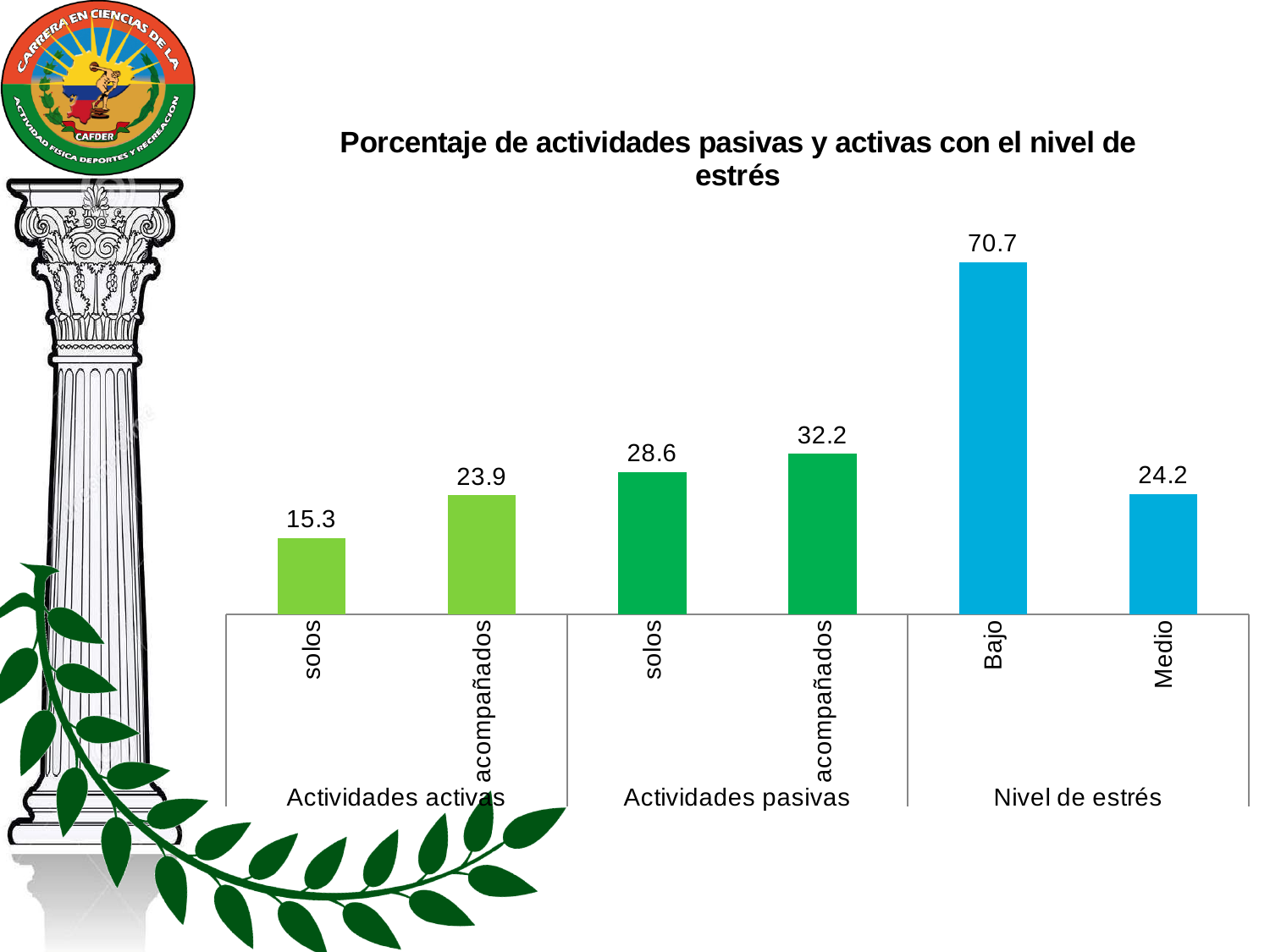
What is the value for 'acompañados' under 'Actividades pasivas'? 32.2 Which bar has the lowest value? solos (Actividades activas) What is the title of the chart? Porcentaje de actividades pasivas y activas con el nivel de estrés Which bar has the highest value? Bajo (Nivel de estrés) What is the difference between 'Bajo' and 'Medio' under 'Nivel de estrés'? 46.5 What is the value for 'Bajo' under 'Nivel de estrés'? 70.7 What is the value for 'Medio' under 'Nivel de estrés'? 24.2 What is the value for 'solos' under 'Actividades activas'? 15.3 What kind of chart is shown on the slide? Bar chart What is the difference between 'acompañados' and 'solos' under 'Actividades activas'? 8.6 How many bars are plotted in the chart? 6 Which is larger: 'solos' under 'Actividades pasivas' or 'acompañados' under 'Actividades activas'? solos under Actividades pasivas